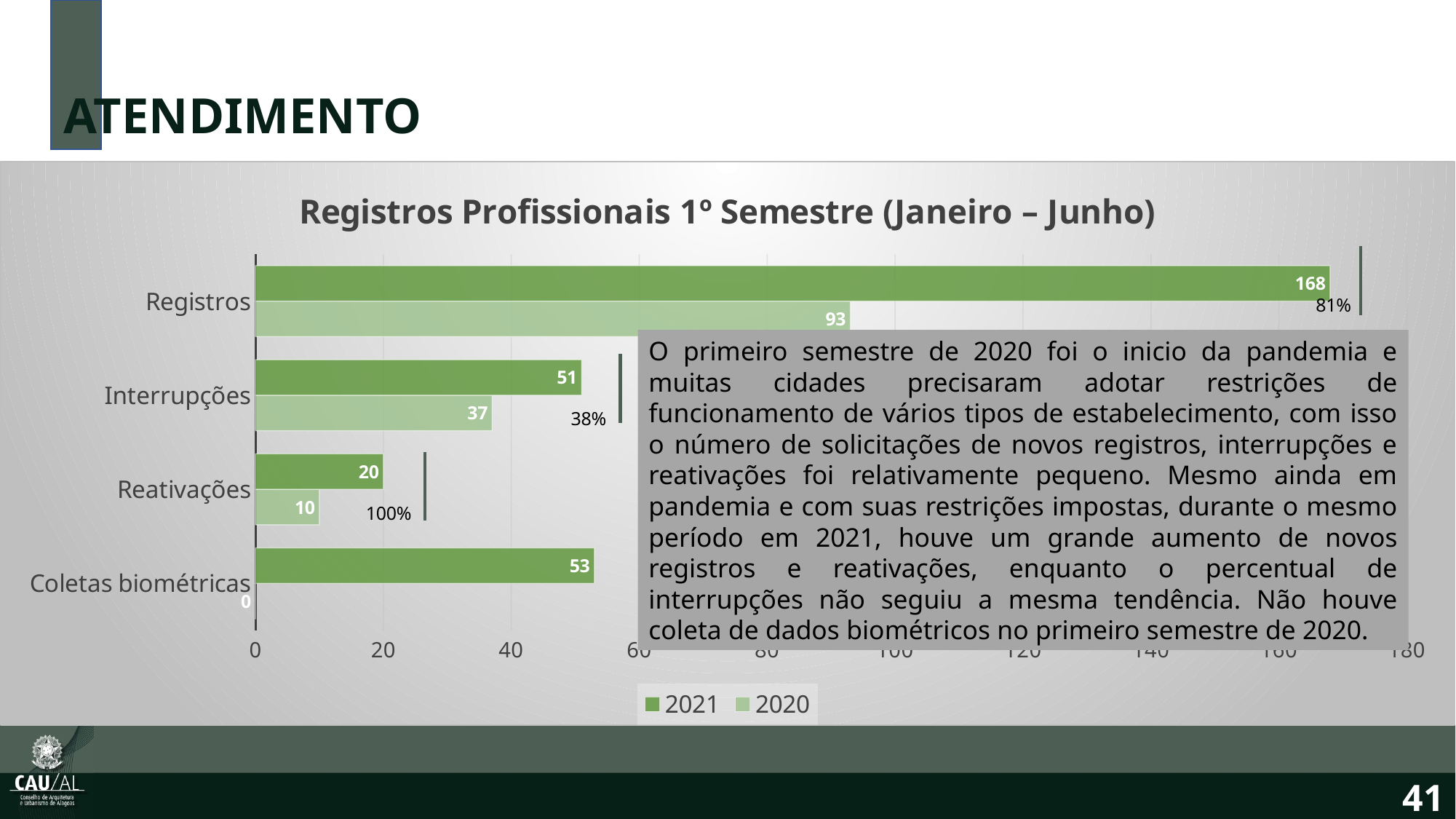
How many series does the legend list? 2 How many categories are shown on the chart? 4 What is the title of the chart? Registros Profissionais 1º Semestre (Janeiro – Junho) What is the value for Registros in 2020? 93 What type of chart is shown on the slide? bar chart What is the value for Interrupções in 2020? 37 Which category has the lowest value for 2020? Coletas biométricas Which is larger, the 2021 value for Interrupções or the 2021 value for Coletas biométricas? Coletas biométricas What is the value for Coletas biométricas in 2020? 0 What is the value for Registros in 2021? 168 What is the difference between the 2021 and 2020 values for Reativações? 10 Which category has the highest value for 2021? Registros